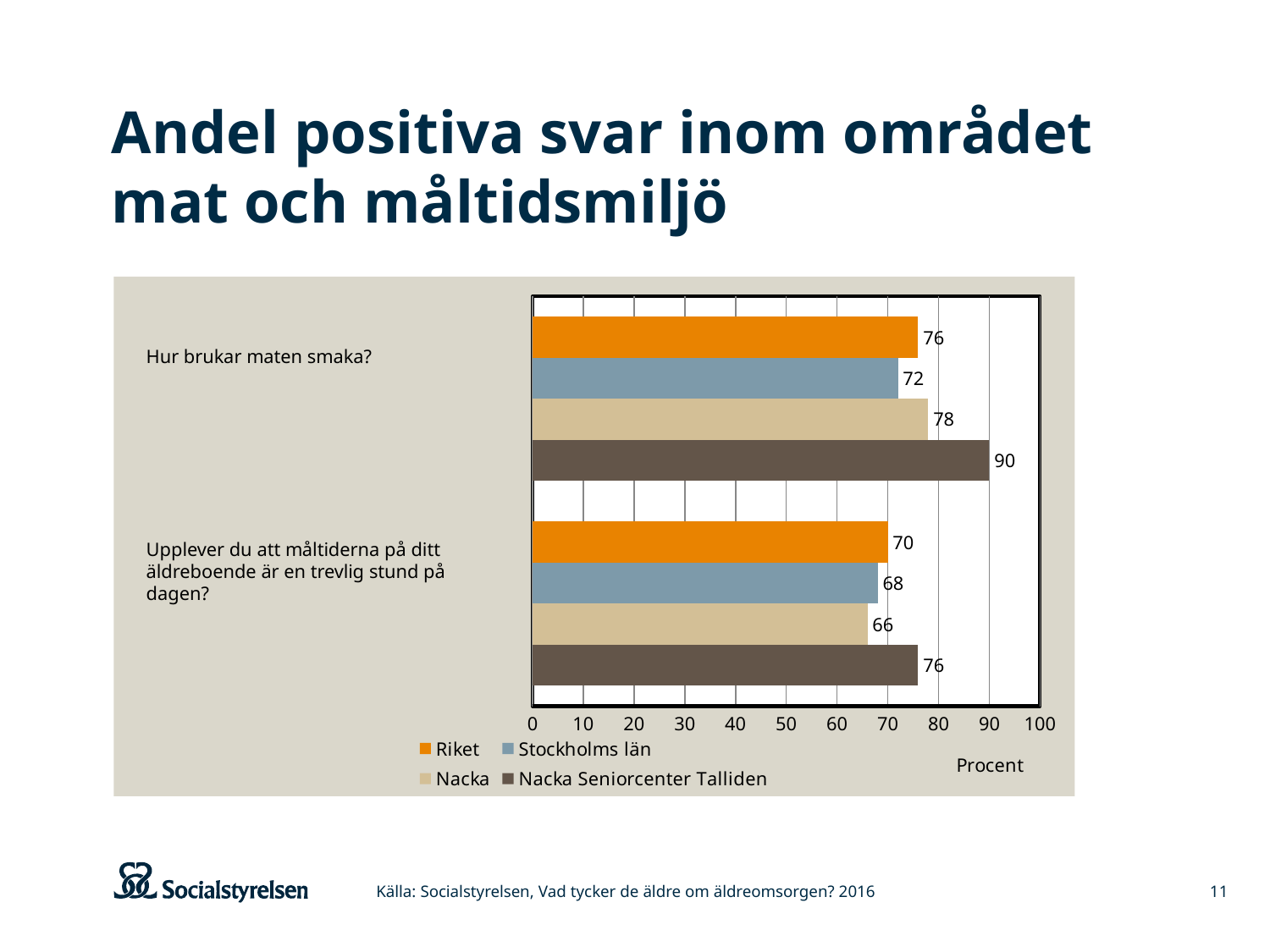
What is the label of the horizontal axis? Procent What is the value for Stockholms län for "Hur brukar maten smaka?"? 72 What is the value for Nacka for "Upplever du att måltiderna på ditt äldreboende är en trevlig stund på dagen?"? 66 How many series does the legend list? 4 What is the value for Riket for "Upplever du att måltiderna på ditt äldreboende är en trevlig stund på dagen?"? 70 Which is larger for "Upplever du att måltiderna på ditt äldreboende är en trevlig stund på dagen?": Riket or Stockholms län? Riket Which series has the highest value for "Hur brukar maten smaka?"? Nacka Seniorcenter Talliden What is the difference between the Nacka Seniorcenter Talliden value and the Riket value for "Hur brukar maten smaka?"? 14 Which series has the lowest value for "Upplever du att måltiderna på ditt äldreboende är en trevlig stund på dagen?"? Nacka How many question categories are shown on the chart? 2 What kind of chart is shown on the slide? Bar chart What is the value for Nacka Seniorcenter Talliden for "Hur brukar maten smaka?"? 90